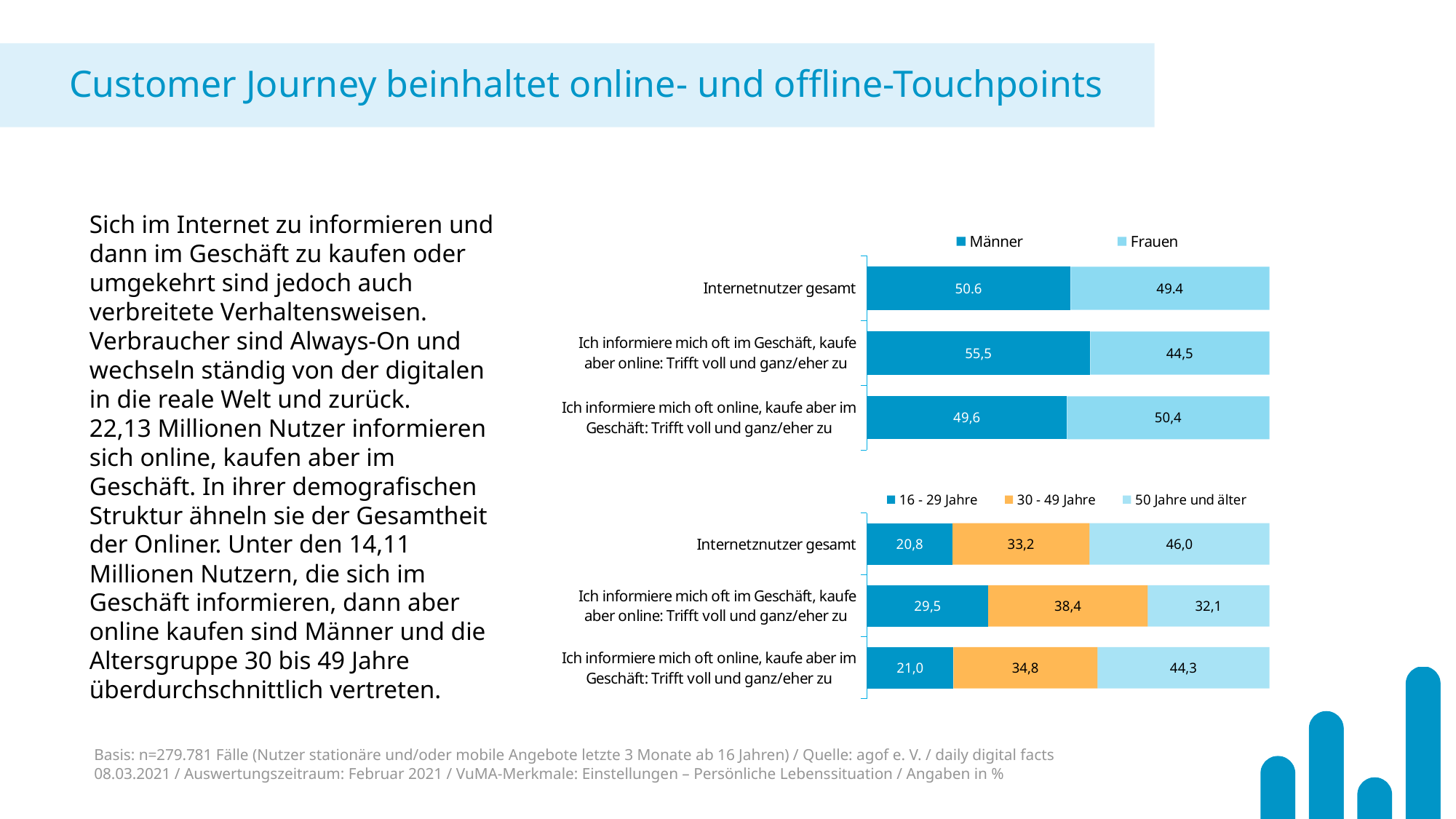
In the bottom chart (age groups), what is the '30 - 49 Jahre' value for 'Ich informiere mich oft im Geschäft, kaufe aber online'? 38,4 In the top chart (Männer/Frauen), how many series does the legend list? 2 In the top chart (Männer/Frauen), what is the Männer value for 'Ich informiere mich oft im Geschäft, kaufe aber online'? 55,5 In the bottom chart (age groups), what is the difference between the '30 - 49 Jahre' values for 'Ich informiere mich oft im Geschäft, kaufe aber online' and 'Internetznutzer gesamt'? 5,2 In the top chart (Männer/Frauen), which category has the highest Männer value? Ich informiere mich oft im Geschäft, kaufe aber online In the bottom chart (age groups), what is the '16 - 29 Jahre' value for 'Ich informiere mich oft online, kaufe aber im Geschäft'? 21,0 In the bottom chart (age groups), which category has the lowest '50 Jahre und älter' value? Ich informiere mich oft im Geschäft, kaufe aber online In the bottom chart (age groups), what is the '50 Jahre und älter' value for 'Internetznutzer gesamt'? 46,0 In the top chart (Männer/Frauen), what is the Frauen value for 'Ich informiere mich oft online, kaufe aber im Geschäft'? 50,4 In the bottom chart (age groups), how many series does the legend list? 3 What kind of chart is the bottom chart (age groups)? Stacked bar chart In the top chart (Männer/Frauen), what is the Frauen value for 'Internetnutzer gesamt'? 49.4